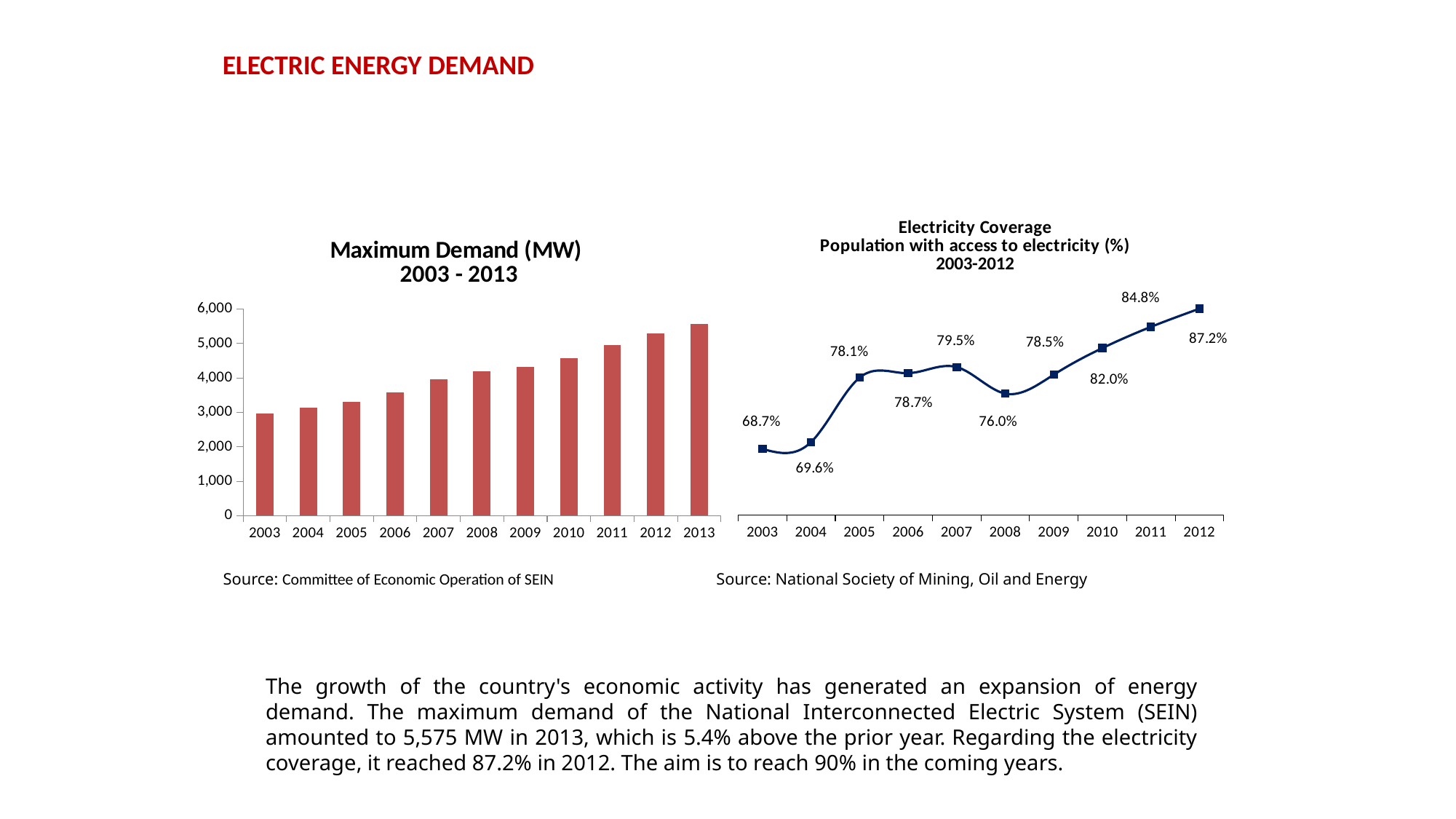
What type of chart is the 'Maximum Demand (MW) 2003 - 2013' chart on the left? Bar chart In the 'Maximum Demand (MW)' chart, is the value for 2010 greater or less than 4,000? greater In the 'Maximum Demand (MW)' chart, how many years are shown on the x axis? 11 In the 'Electricity Coverage' chart, what is the value for 2008? 76.0% In the 'Maximum Demand (MW)' chart, which year has the lowest bar? 2003 In the 'Electricity Coverage' chart, what is the difference between the 2012 value and the 2003 value? 18.5 percentage points In the 'Electricity Coverage' chart, what is the value for 2012? 87.2% In the 'Electricity Coverage' chart, which year has the lowest value? 2003 In the 'Maximum Demand (MW)' chart, do the values generally rise or fall from 2003 to 2013? Rise In the 'Maximum Demand (MW)' chart, is the value for 2013 greater or less than 5,000? greater What type of chart is the 'Electricity Coverage' chart on the right? Line chart In the 'Maximum Demand (MW)' chart, which year has the highest bar? 2013